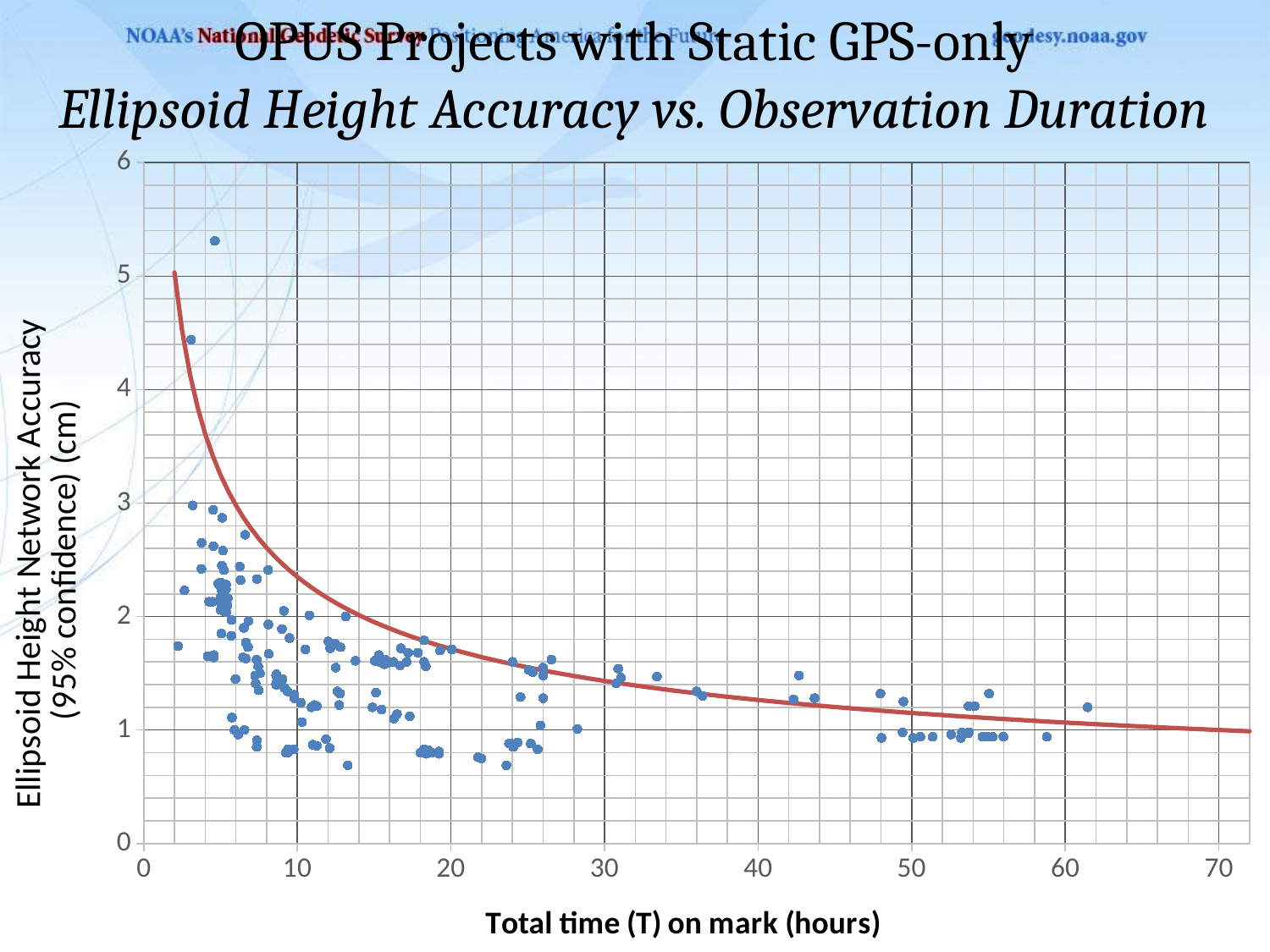
Which has the larger accuracy value: the point plotted near 4 hours at the top of the chart or the point plotted near 59 hours? the point near 4 hours What is the label of the x axis? Total time (T) on mark (hours) As total time on mark increases along the x axis, does the fitted red curve rise or fall? fall Is the highest plotted point's ellipsoid height accuracy value greater or less than 5? greater What kind of chart is shown on the slide? scatter chart Is the accuracy value of the point plotted near 61 hours greater or less than 2? less Is the value of the fitted red curve at 30 hours greater or less than 1? greater What is the label of the y axis? Ellipsoid Height Network Accuracy (95% confidence) (cm) What is the maximum value shown on the y axis? 6